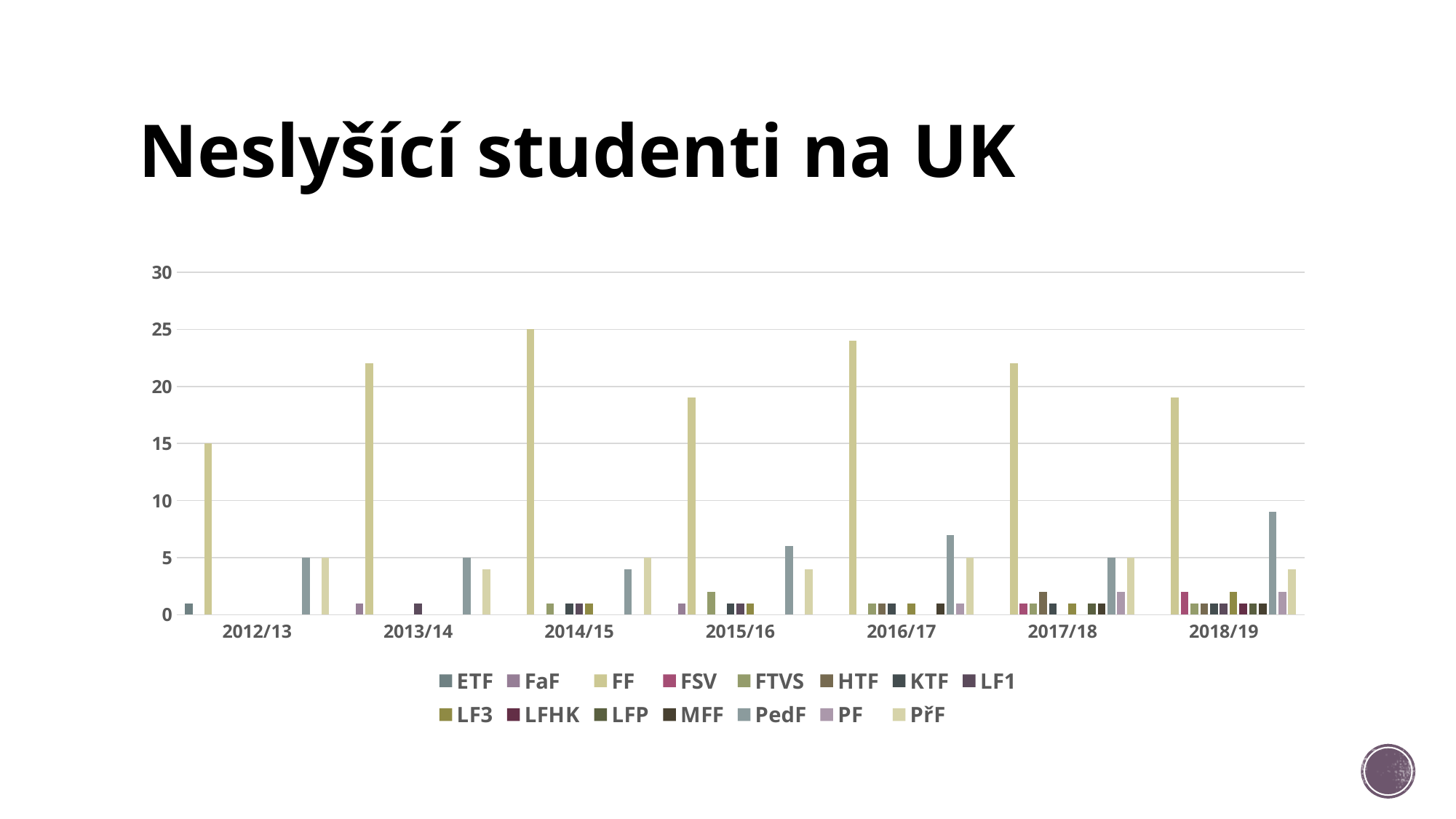
How many academic years are shown on the x axis? 7 Is the value for FF in 2013/14 greater or less than 20? greater In which academic year is the FF value lowest? 2012/13 What is the title of the chart? Neslyšící studenti na UK What is the value for PedF in 2012/13? 5 What is the value for FF in 2014/15? 25 What is the value for FF in 2012/13? 15 Which is larger, the PedF value in 2018/19 or the PedF value in 2017/18? 2018/19 What kind of chart is shown on the slide? bar chart How many series does the legend list? 15 In which academic year is the FF value highest? 2014/15 What is the difference between the FF value in 2014/15 and the FF value in 2012/13? 10